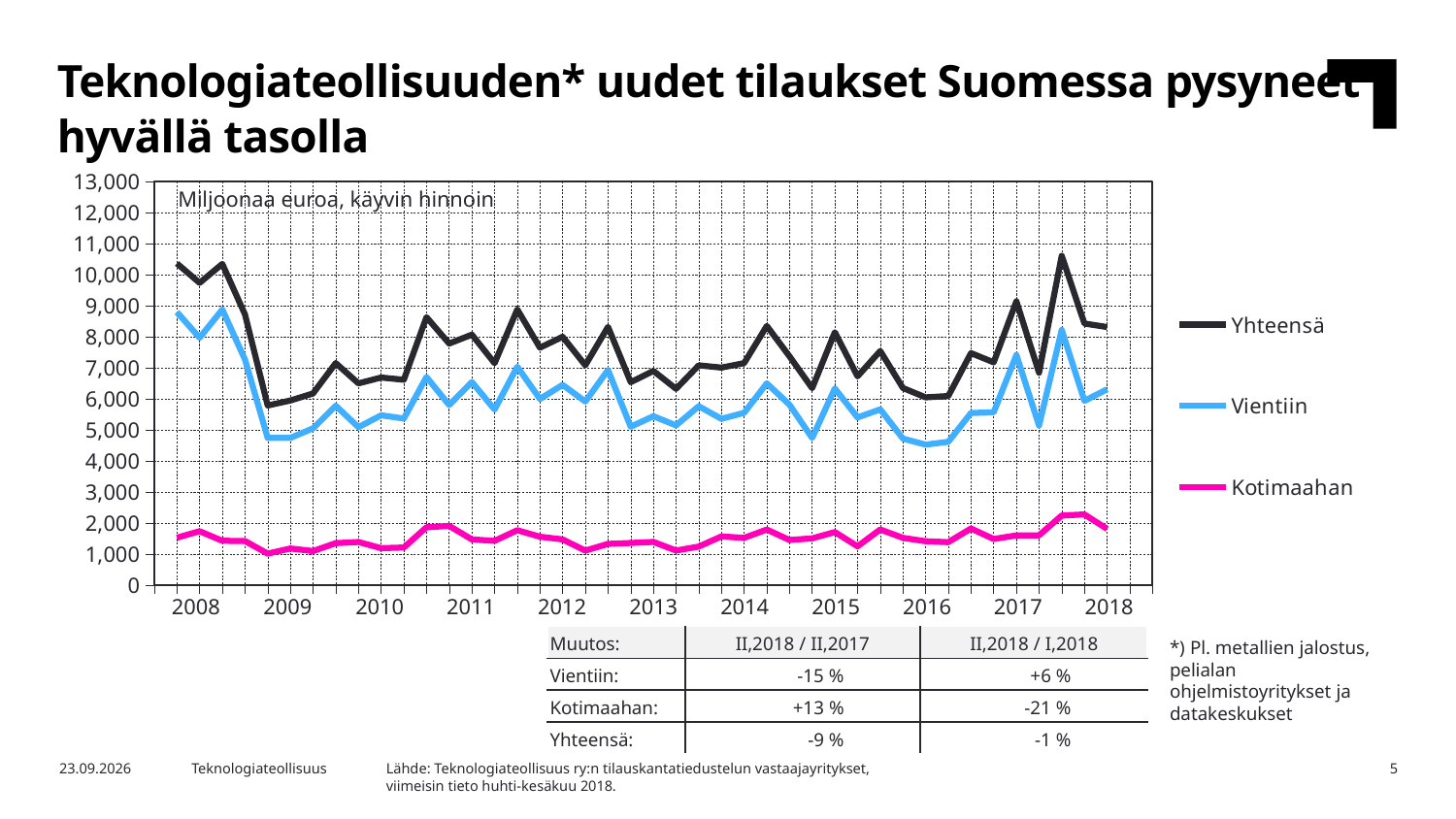
Is the value for Kotimaahan at 2018 greater or less than 3,000? less Does the Yhteensä line rise or fall between 2008 and 2009? fall Is the value for Yhteensä at the start of 2008 greater or less than 9,000? greater What are the series names listed in the chart's legend? Yhteensä, Vientiin, Kotimaahan Is the value for Vientiin at 2009 greater or less than 6,000? less What unit label is printed inside the chart's plot area? Miljoonaa euroa, käyvin hinnoin How many year labels are shown on the x axis? 11 How many series does the chart's legend list? 3 What kind of chart is shown on the slide? line chart Which series has the lowest values across the whole chart? Kotimaahan At 2015, which is larger: the value for Vientiin or the value for Kotimaahan? Vientiin Which series has the highest values across the whole chart? Yhteensä